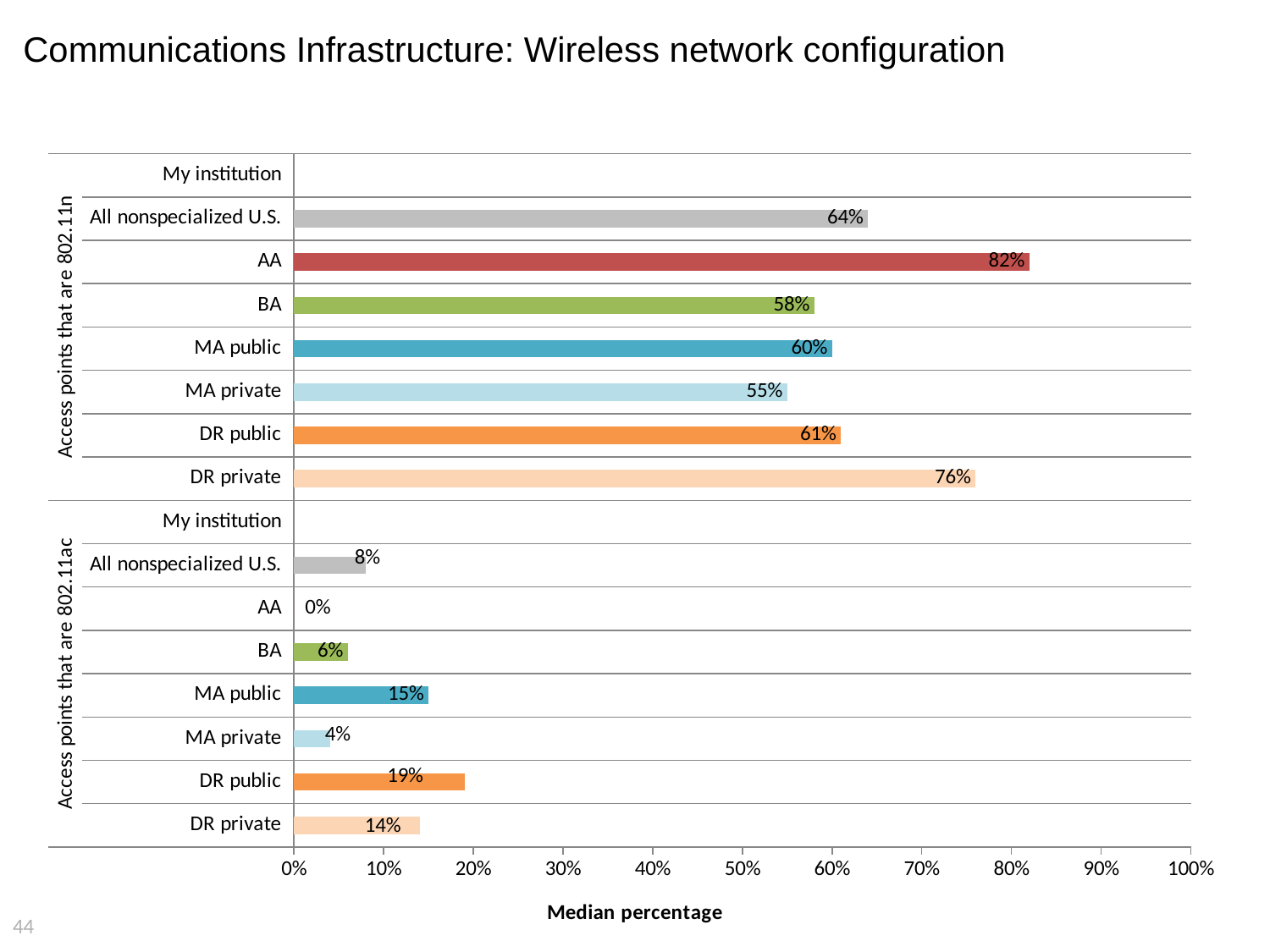
What is the median percentage of access points that are 802.11n for AA institutions? 82% Which institution type has the highest median percentage of access points that are 802.11n? AA Which institution type has the lowest median percentage of access points that are 802.11ac? AA For access points that are 802.11ac, which is larger: the value for BA or the value for All nonspecialized U.S.? All nonspecialized U.S. Which institution type has the lowest median percentage of access points that are 802.11n? MA private Is the 802.11n value for DR private greater or less than 70%? greater What is the difference between the 802.11n median percentages for DR private and DR public? 15% What is the median percentage of access points that are 802.11n for All nonspecialized U.S. institutions? 64% What kind of chart is shown on the slide? Bar chart What is the median percentage of access points that are 802.11ac for DR public institutions? 19% What is the label of the horizontal axis of the chart? Median percentage What is the difference between the 802.11ac median percentages for MA public and MA private? 11%